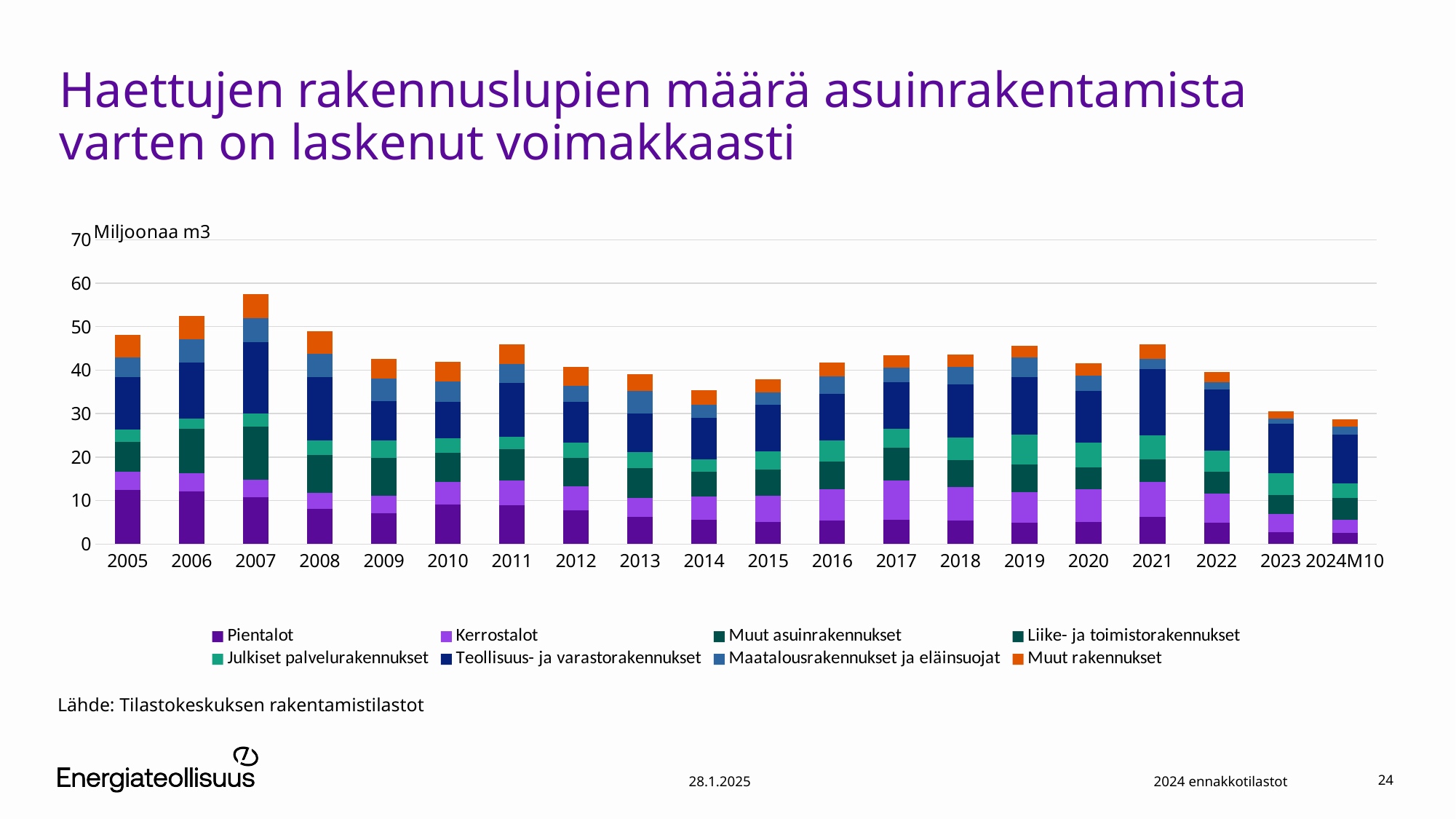
What kind of chart is shown on the slide? stacked bar chart Which total bar is larger, 2006 or 2013? 2006 What unit is shown at the top of the y axis? Miljoonaa m3 How many series does the legend list? 8 Is the total for 2005 greater or less than 40? greater Which category has the lowest total bar? 2024M10 Which year has the highest total bar? 2007 How many years (categories) are shown on the x axis? 20 Is the total for 2023 greater or less than 40? less Is the total for 2014 greater or less than 40? less Do the total bars generally rise or fall from 2005 to 2024M10? fall